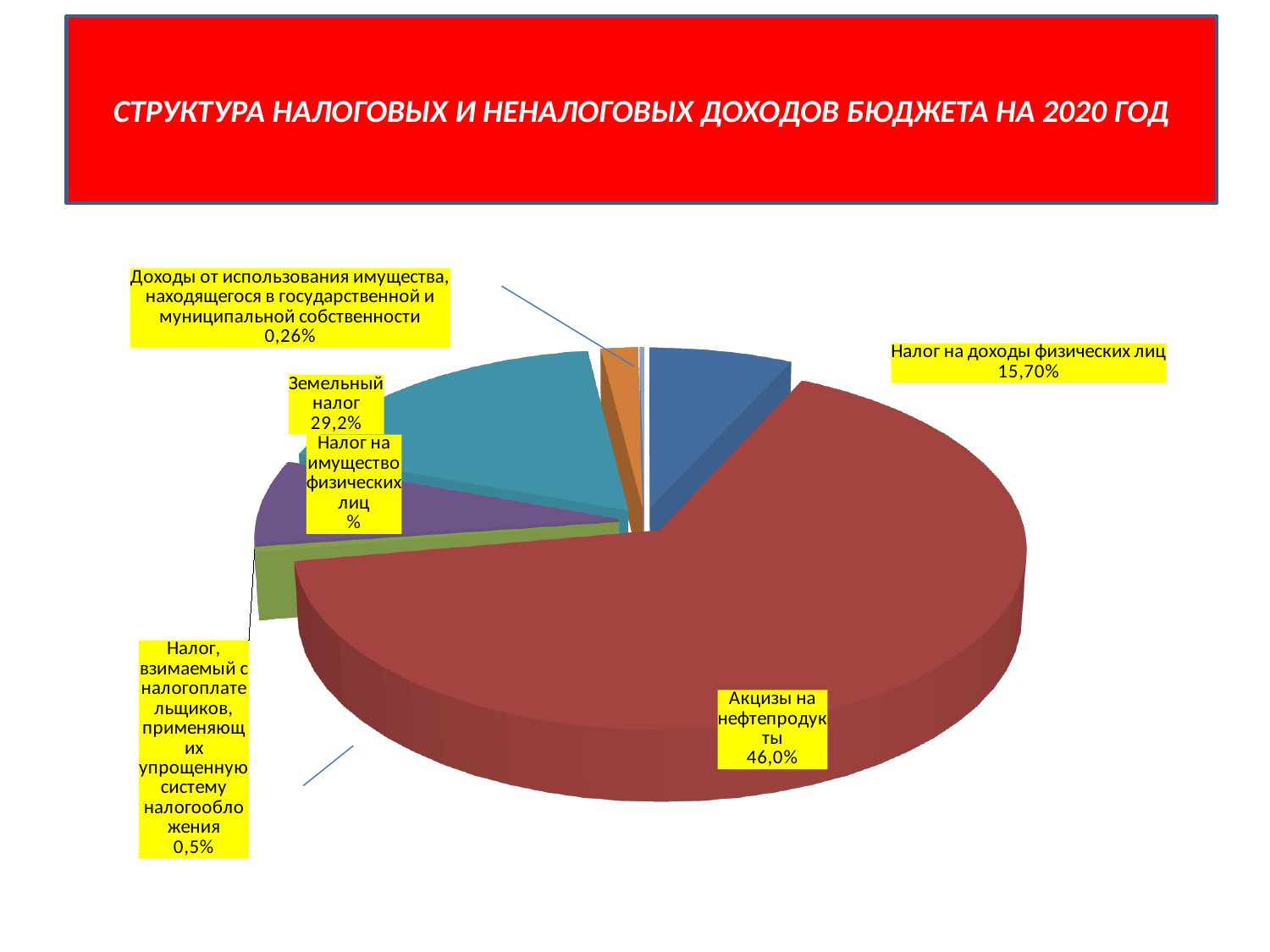
What share is shown for Земельный налог? 29,2% What colour is the slice for Акцизы на нефтепродукты? Red By how many percentage points does the share of Акцизы на нефтепродукты exceed the share of Налог на доходы физических лиц? 30,3% What share is shown for Налог на доходы физических лиц? 15,70% What kind of chart is shown on the slide? Pie chart What share of the pie is labelled for Акцизы на нефтепродукты? 46,0% Which labelled category has the smallest share of the pie? Доходы от использования имущества, находящегося в государственной и муниципальной собственности Which category has the largest share of the pie? Акцизы на нефтепродукты What share is shown for the tax levied on taxpayers applying the simplified taxation system (Налог, взимаемый с налогоплательщиков, применяющих упрощенную систему налогообложения)? 0,5% What is the title of the slide containing the chart? СТРУКТУРА НАЛОГОВЫХ И НЕНАЛОГОВЫХ ДОХОДОВ БЮДЖЕТА НА 2020 ГОД Which is larger: the share for Земельный налог or the share for Налог на доходы физических лиц? Земельный налог What share is shown for Доходы от использования имущества, находящегося в государственной и муниципальной собственности? 0,26%